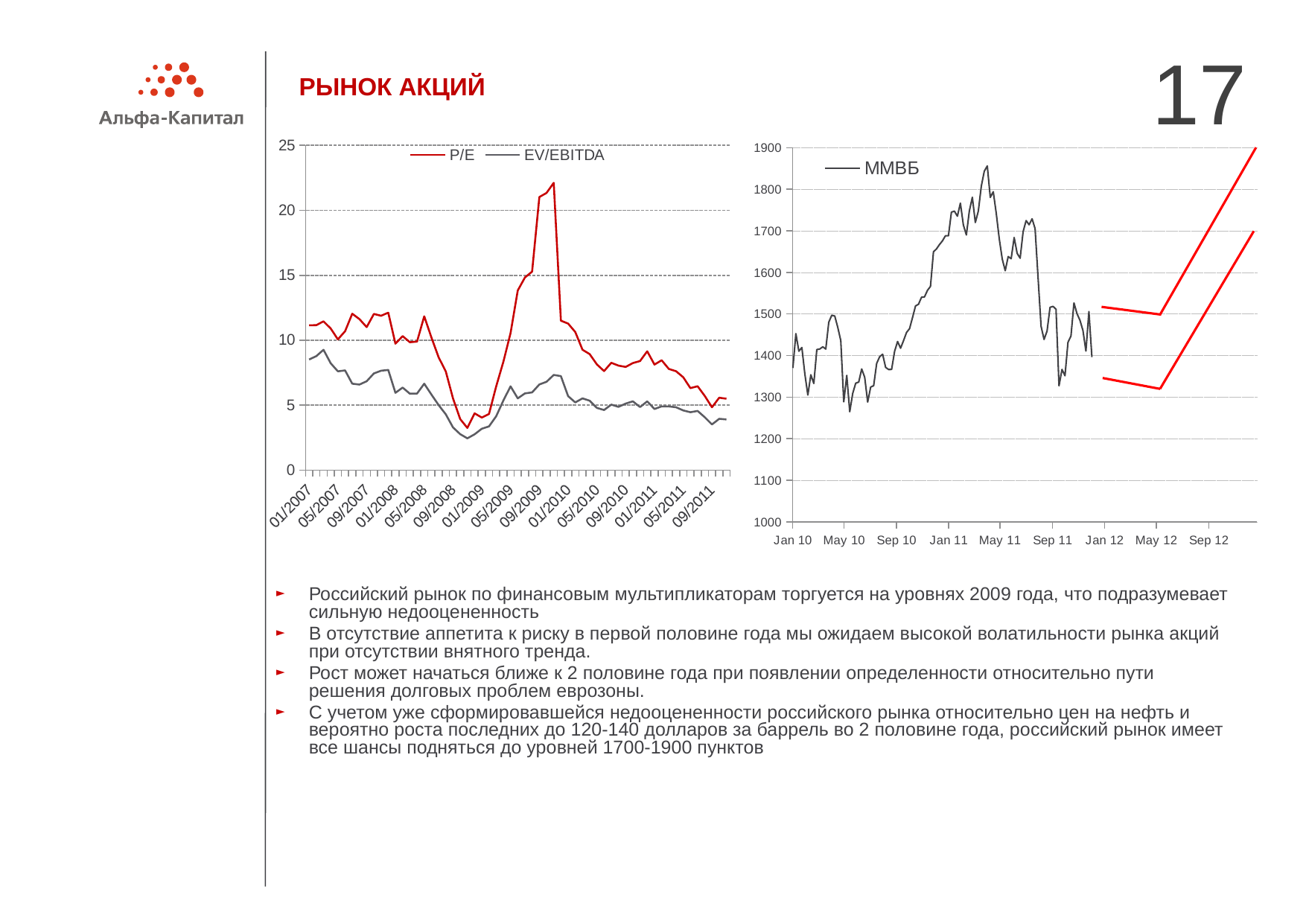
In the left chart, which series is higher at 01/2007, P/E or EV/EBITDA? P/E What kind of chart is the right chart showing ММВБ? line chart What kind of chart is the left chart showing P/E and EV/EBITDA? line chart In the left chart, is the peak value of P/E around 09/2009–01/2010 greater or less than 20? greater In the right chart, is the lowest value of ММВБ in mid-2010 greater or less than 1300? less In the left chart, is the value of EV/EBITDA at 01/2007 greater or less than 10? less How many series does the legend of the right chart list? 1 In the right chart, does the ММВБ line rise or fall between Sep 10 and Jan 11? rise How many series does the legend of the left chart list? 2 In the left chart, which two series are listed in the legend? P/E and EV/EBITDA